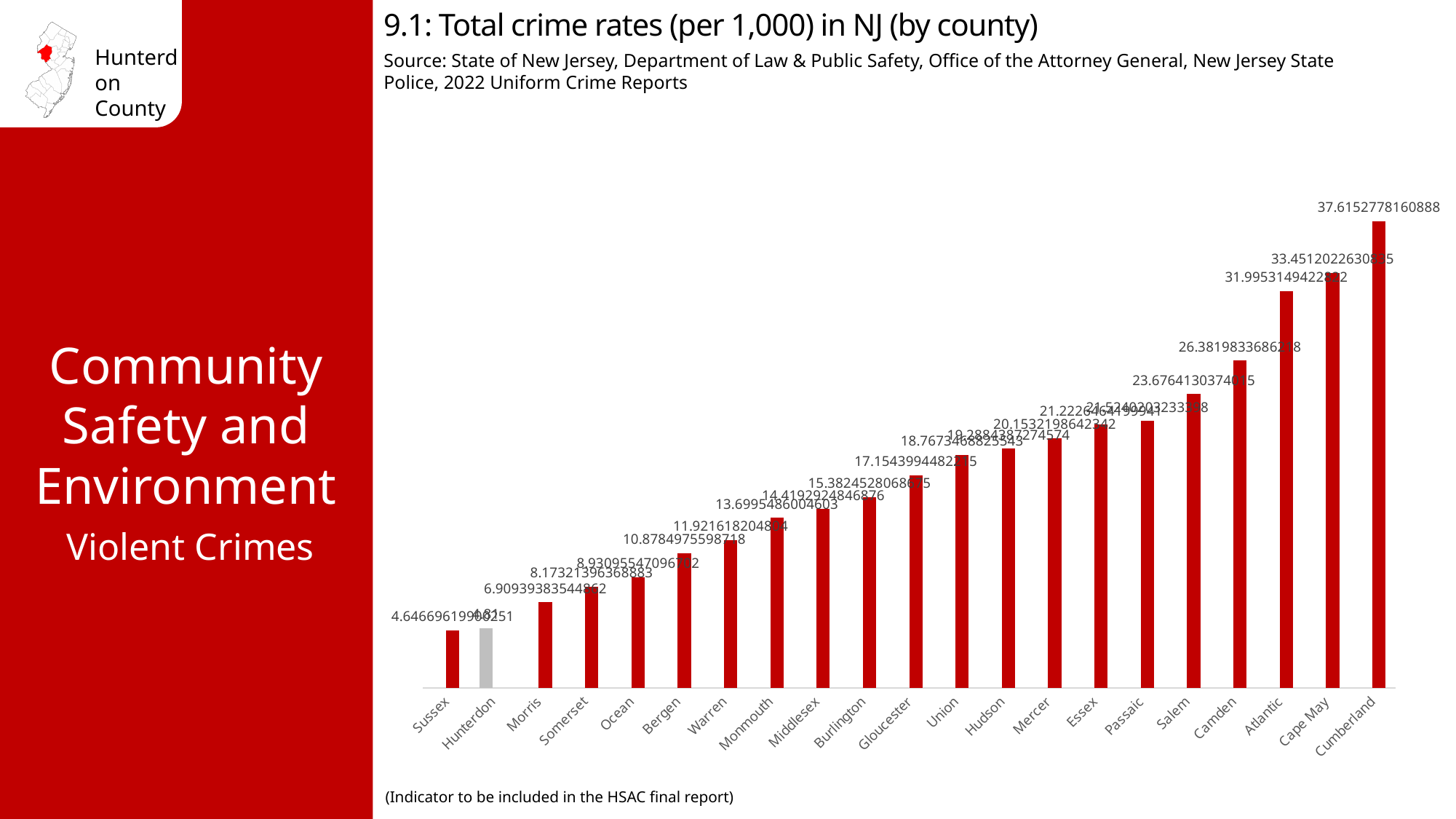
What is the total crime rate (per 1,000) shown for Cumberland? 37.6152778160888 Which county's bar is coloured grey instead of red? Hunterdon How many counties are shown on the x axis of the chart? 21 Do the values rise or fall moving from left to right along the x axis? rise What is the total crime rate (per 1,000) shown for Gloucester? 17.1543994482215 Which county has the lowest total crime rate in the chart? Sussex What is the total crime rate (per 1,000) shown for Morris? 6.90939383544862 What kind of chart is shown on the slide? bar chart Which county has a higher total crime rate, Camden or Morris? Camden Which county has the highest total crime rate in the chart? Cumberland What is the total crime rate (per 1,000) shown for Ocean? 8.93095547096702 Which county has a higher total crime rate, Atlantic or Union? Atlantic